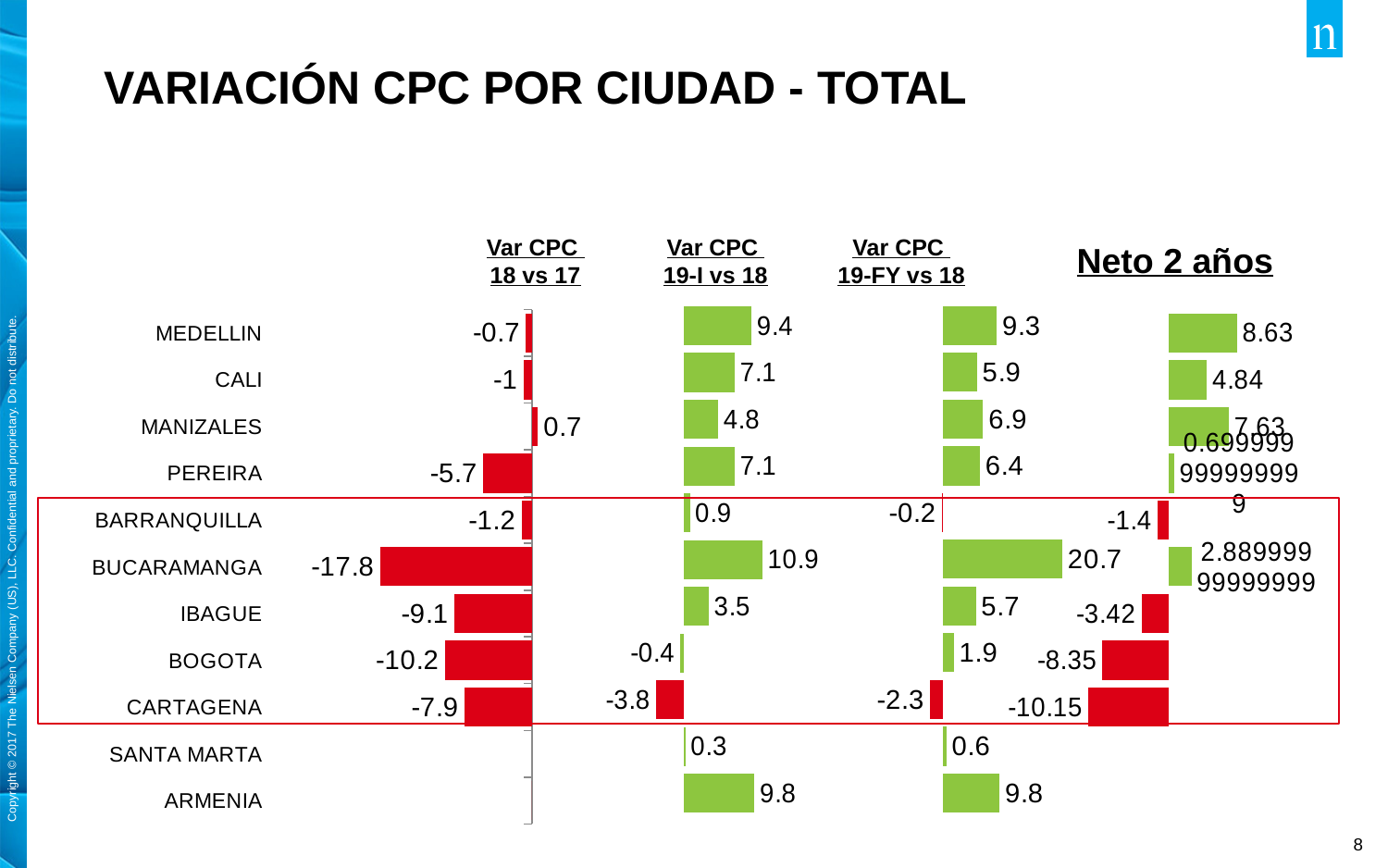
In the 'Var CPC 19-I vs 18' chart, which is larger, the value for CALI or the value for MANIZALES? CALI In the 'Var CPC 19-I vs 18' chart, which city has the lowest value? CARTAGENA In the 'Var CPC 19-FY vs 18' chart, what is the value for BUCARAMANGA? 20.7 How many cities are listed on the slide? 11 In the 'Var CPC 19-FY vs 18' chart, which city has the highest value? BUCARAMANGA What kind of chart is used for 'Var CPC 19-FY vs 18'? Bar chart In the 'Var CPC 18 vs 17' chart, which city has the lowest value? BUCARAMANGA In the 'Var CPC 18 vs 17' chart, what is the value for BUCARAMANGA? -17.8 In the 'Var CPC 18 vs 17' chart, which is larger, the value for IBAGUE or the value for BOGOTA? IBAGUE In the 'Var CPC 19-FY vs 18' chart, what is the difference between the values for BUCARAMANGA and MEDELLIN? 11.4 In the 'Var CPC 19-I vs 18' chart, what is the value for MEDELLIN? 9.4 In the 'Neto 2 años' chart, what is the value for CARTAGENA? -10.15